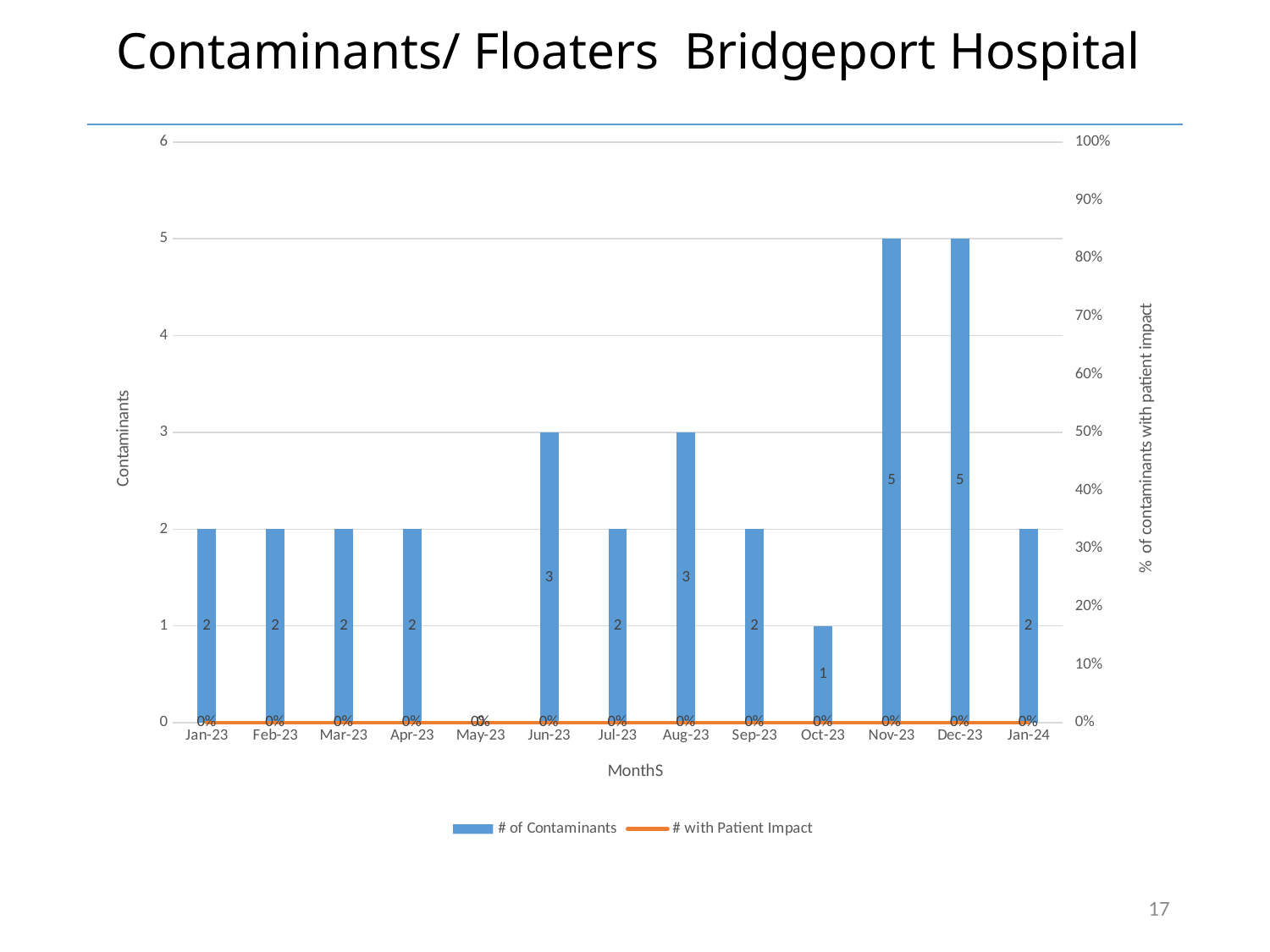
How many series does the legend list? 2 What is the highest # of Contaminants value shown in any month? 5 Is the # of Contaminants value for Dec-23 greater or less than 4? greater What is the title of the x axis? MonthS Which month has the lowest # of Contaminants? May-23 What is the # of Contaminants value for Oct-23? 1 What is the # of Contaminants value for Jan-24? 2 What is the # of Contaminants value for Aug-23? 3 What is the difference in # of Contaminants between Nov-23 and Oct-23? 4 Which month has a higher # of Contaminants, Jun-23 or Jul-23? Jun-23 What is the # with Patient Impact value for Sep-23? 0% How many months are shown on the x axis? 13